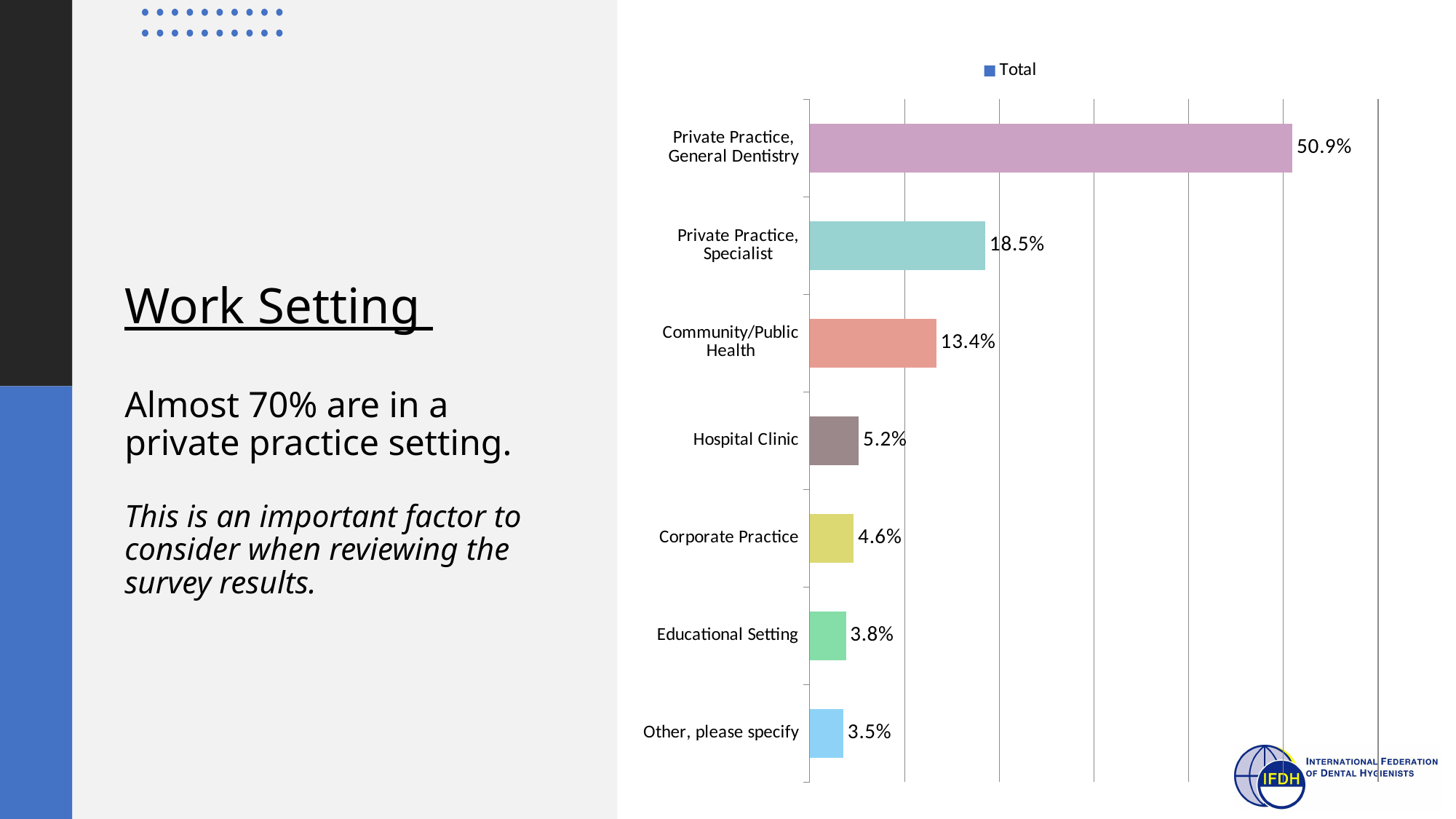
What kind of chart is shown on the slide? Bar chart What is the value for Private Practice, General Dentistry? 50.9% What is the value for Community/Public Health? 13.4% What is the difference between Private Practice, General Dentistry and Private Practice, Specialist? 32.4% Which category has the highest value? Private Practice, General Dentistry What is the value for Educational Setting? 3.8% How many categories are shown in the chart? 7 What is the name of the series shown in the legend? Total Which category has the lowest value? Other, please specify How many series does the legend list? 1 What is the difference between Hospital Clinic and Corporate Practice? 0.6% Which is larger, Private Practice, Specialist or Community/Public Health? Private Practice, Specialist